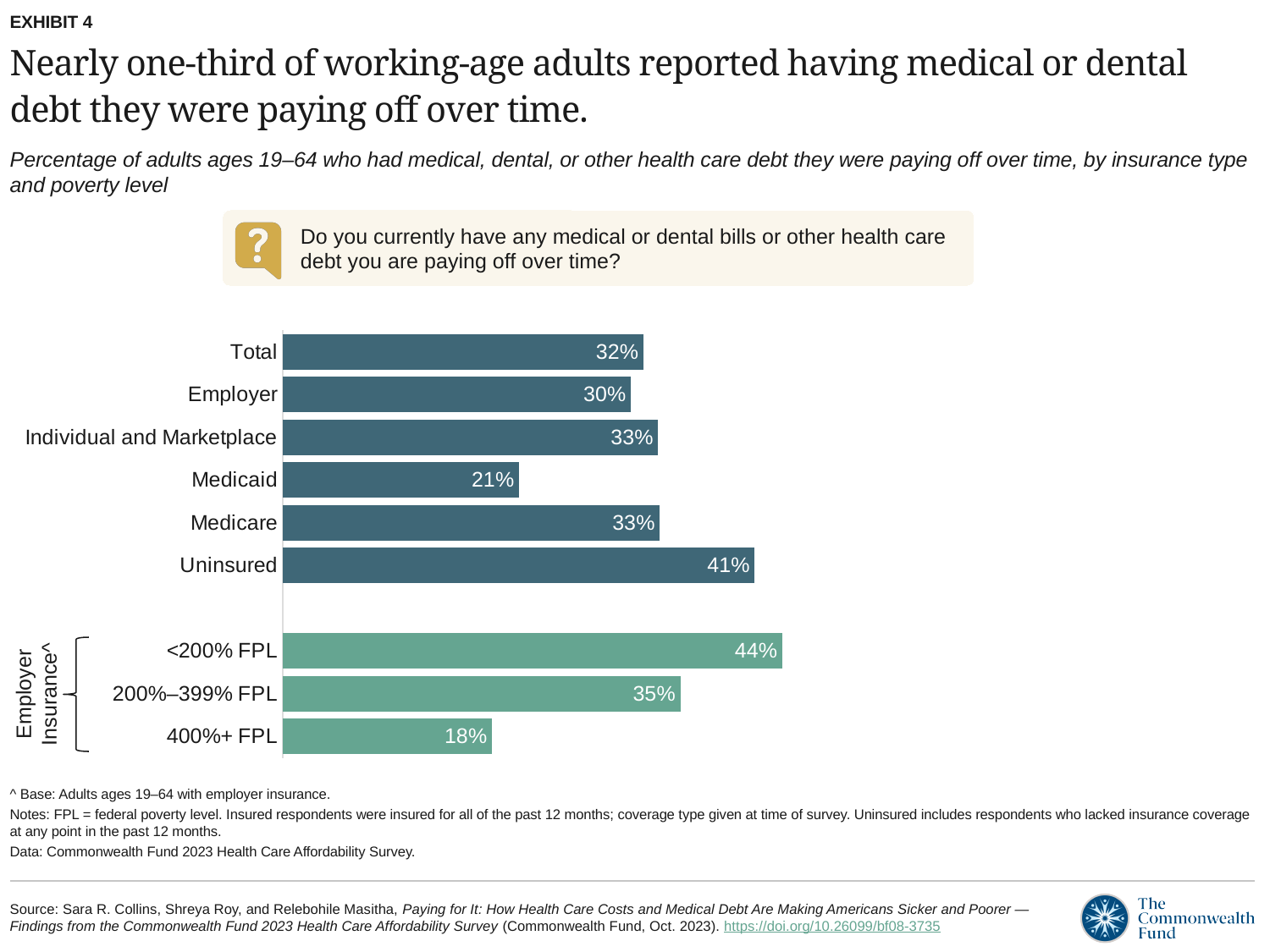
Which is larger, the value for Medicare or the value for Medicaid? Medicare Which category has the lowest value on the chart? 400%+ FPL How many bars are plotted on the chart? 9 What percentage is shown for the Total category? 32% What is the value for the Uninsured category? 41% What is the difference between the values for Uninsured and Employer? 11 percentage points Which category has the highest value on the chart? <200% FPL What is the value for adults with employer insurance at 400%+ FPL? 18% What percentage of adults with Medicaid reported having medical or dental debt they were paying off over time? 21% What is the difference between the values for <200% FPL and 400%+ FPL? 26 percentage points Among the insurance types (Employer, Individual and Marketplace, Medicaid, Medicare, Uninsured), which has the lowest value? Medicaid What type of chart is shown on the slide? Bar chart